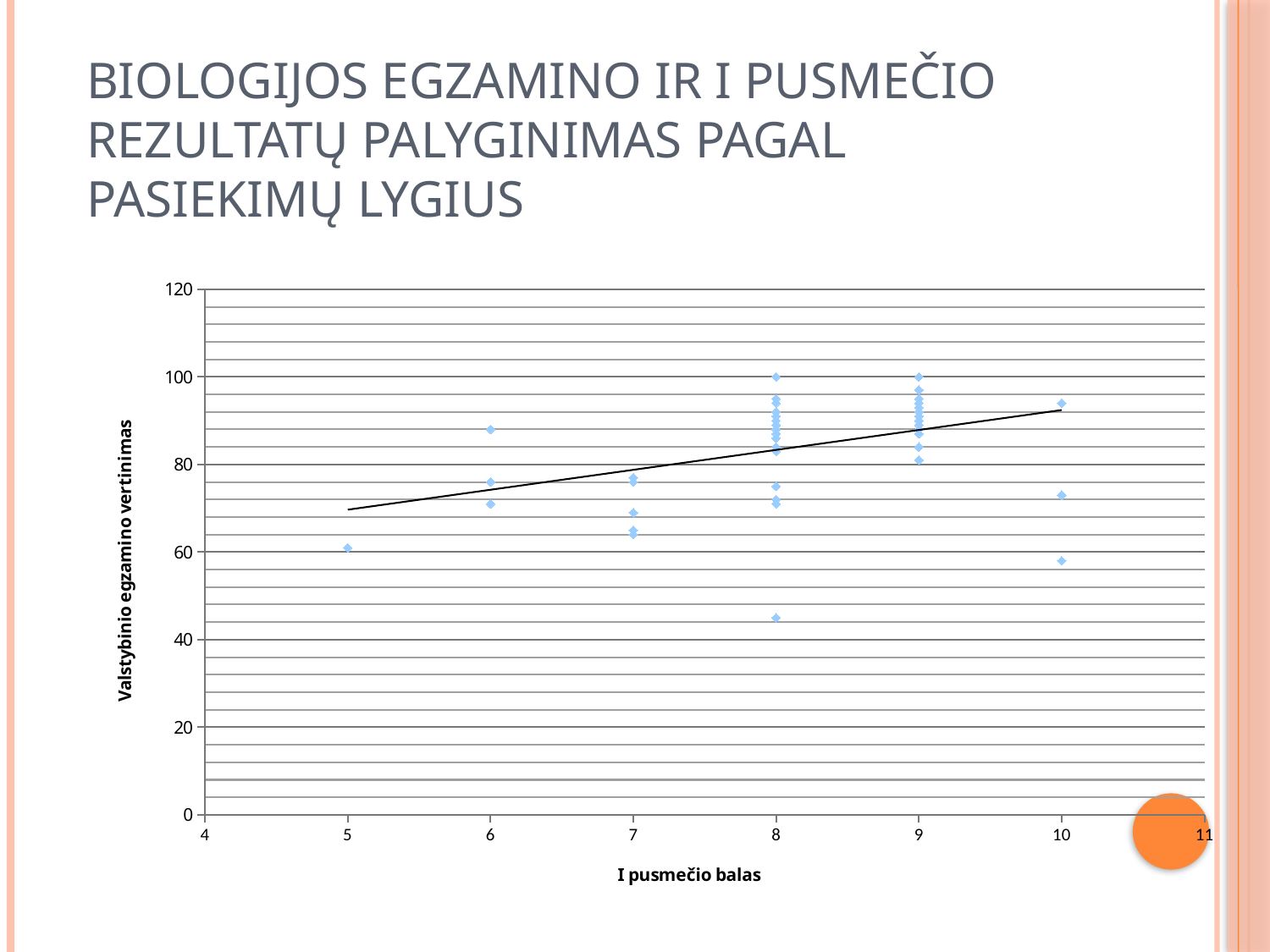
How many points are plotted at x = 10? 3 Is the value of the single point at x = 5 greater or less than 80? less What is the title of the y axis of the chart? Valstybinio egzamino vertinimas How many distinct x-axis values have points plotted on the chart? 6 Is the highest point at x = 6 greater or less than 80? greater Is the lowest point at x = 10 greater or less than 40? greater What is the title of the x axis of the chart? I pusmečio balas Does the trend line in the chart rise or fall as the x-axis value increases? rise How many points are plotted at x = 5? 1 What kind of chart is shown on the slide? scatter chart